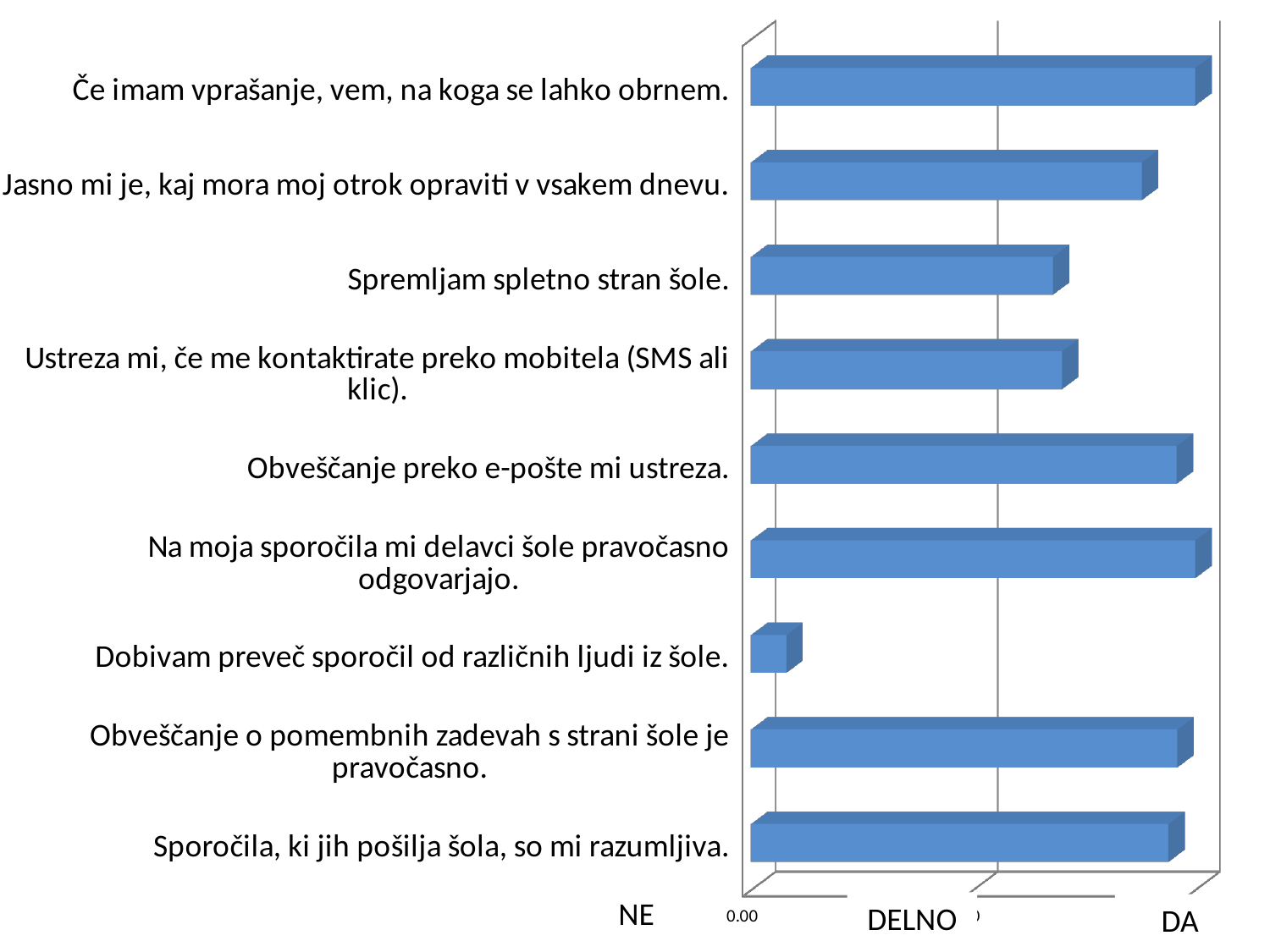
Which statement has the lowest value in the chart? Dobivam preveč sporočil od različnih ljudi iz šole. How many categories (statements) are plotted in the chart? 9 What kind of chart is shown on the slide? bar chart Which has the larger value: "Če imam vprašanje, vem, na koga se lahko obrnem." or "Ustreza mi, če me kontaktirate preko mobitela (SMS ali klic)."? Če imam vprašanje, vem, na koga se lahko obrnem. Which has the larger value: "Obveščanje preko e-pošte mi ustreza." or "Dobivam preveč sporočil od različnih ljudi iz šole."? Obveščanje preko e-pošte mi ustreza. Which has the larger value: "Obveščanje o pomembnih zadevah s strani šole je pravočasno." or "Dobivam preveč sporočil od različnih ljudi iz šole."? Obveščanje o pomembnih zadevah s strani šole je pravočasno. What colour are the bars in the chart? blue What are the three labels shown along the horizontal axis of the chart? NE, DELNO, DA